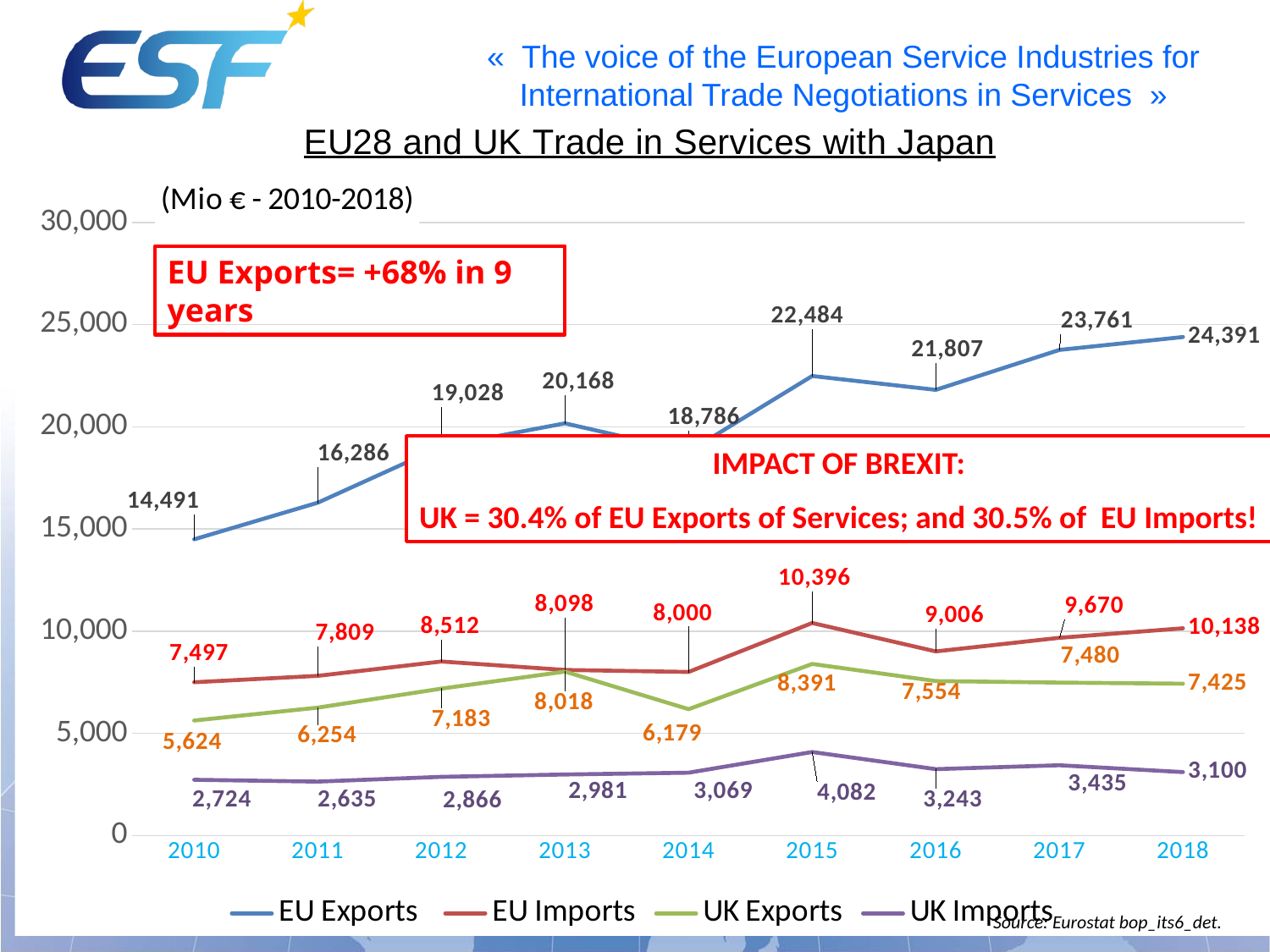
What was the value of UK Exports in 2013? 8,018 In which year were UK Imports lowest? 2011 What was the value of EU Exports in 2018? 24,391 Did EU Exports rise or fall between 2010 and 2018 overall? Rise In which year were EU Exports highest? 2018 Which was larger in 2014: UK Exports or EU Imports? EU Imports How many series does the legend list? 4 What was the value of UK Imports in 2010? 2,724 What is the difference between EU Exports in 2018 and EU Exports in 2010? 9,900 What was the value of EU Imports in 2015? 10,396 What kind of chart is shown on the slide? Line chart How many years are shown on the x axis? 9